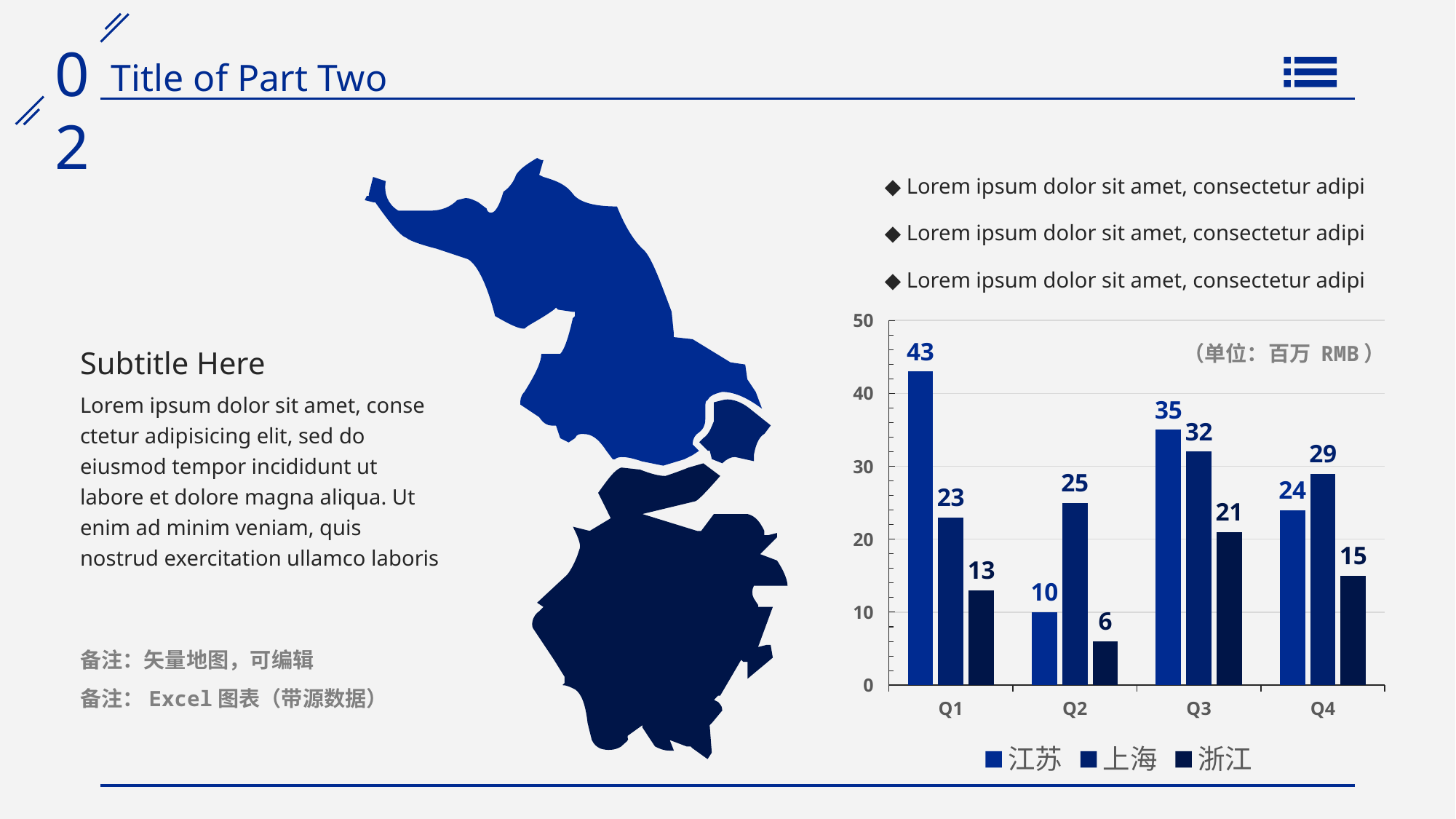
What is the value for 上海 in Q2? 25 What is the value for 江苏 in Q1? 43 What is the value for 浙江 in Q4? 15 How many series does the legend list? 3 What is the difference between the 江苏 and 上海 values in Q1? 20 What kind of chart is shown on the slide? bar chart Is the value for 上海 in Q3 greater or less than 30? greater How many quarters are shown on the x axis? 4 What unit is stated on the chart? 百万 RMB Which is larger in Q4, the value for 江苏 or the value for 上海? 上海 In which quarter does 浙江 have its lowest value? Q2 In which quarter does 江苏 have its highest value? Q1